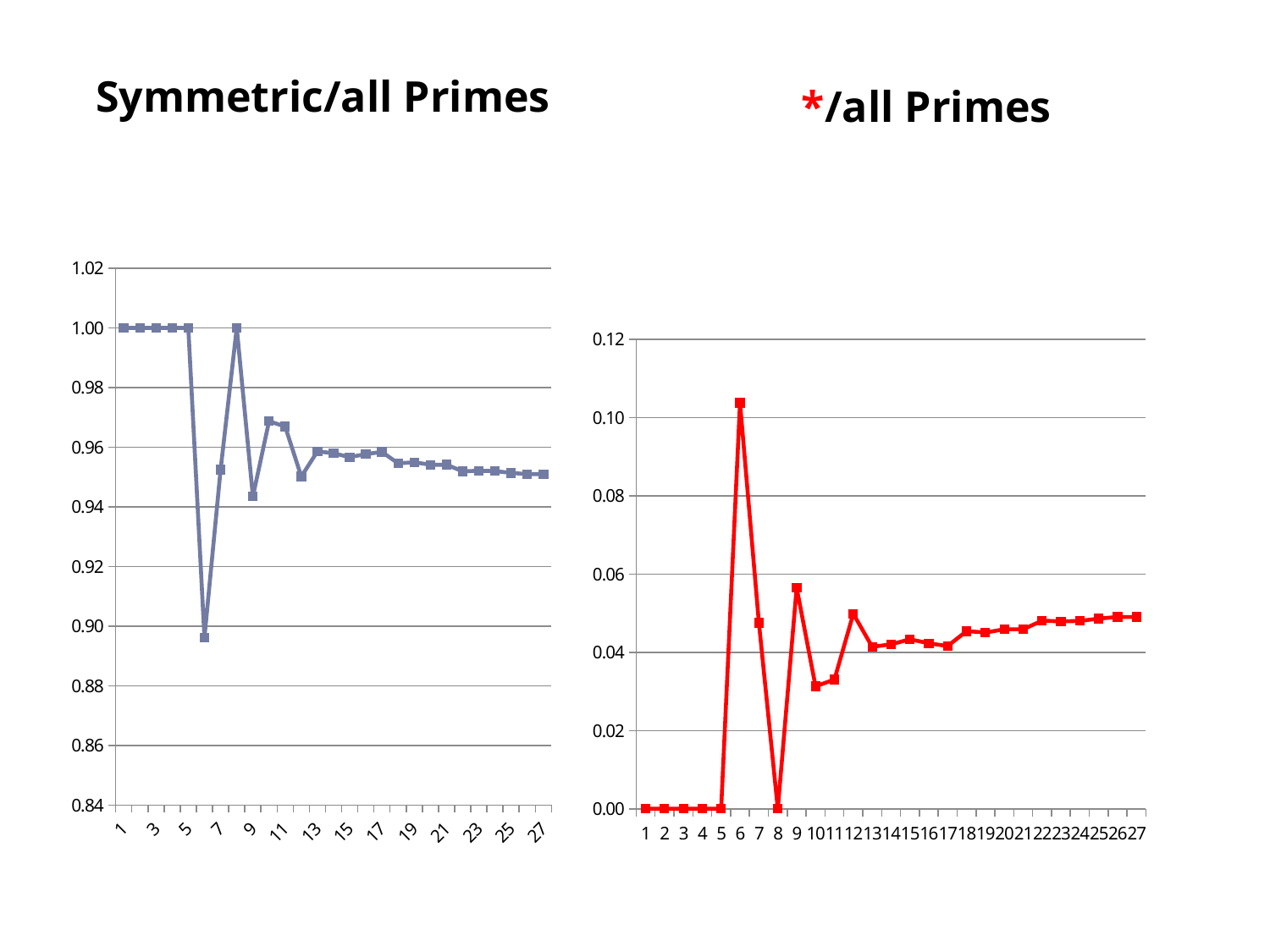
In the "*/all Primes" chart, do the values generally rise or fall from x = 13 to x = 27? rise In the "*/all Primes" chart, is the value at x = 9 greater or less than 0.04? greater What colour is the line in the "*/all Primes" chart? red In the "*/all Primes" chart, at which x value is the highest point? 6 In the "*/all Primes" chart, which is larger, the value at x = 6 or the value at x = 9? x = 6 In the "Symmetric/all Primes" chart, what is the value at x = 1? 1.00 In the "Symmetric/all Primes" chart, which is larger, the value at x = 6 or the value at x = 8? x = 8 How many data points are plotted in the "*/all Primes" chart? 27 In the "Symmetric/all Primes" chart, is the value at x = 6 greater or less than 0.92? less In the "*/all Primes" chart, what is the value at x = 3? 0.00 In the "Symmetric/all Primes" chart, at which x value is the lowest point? 6 What kind of chart is the "Symmetric/all Primes" chart? line chart